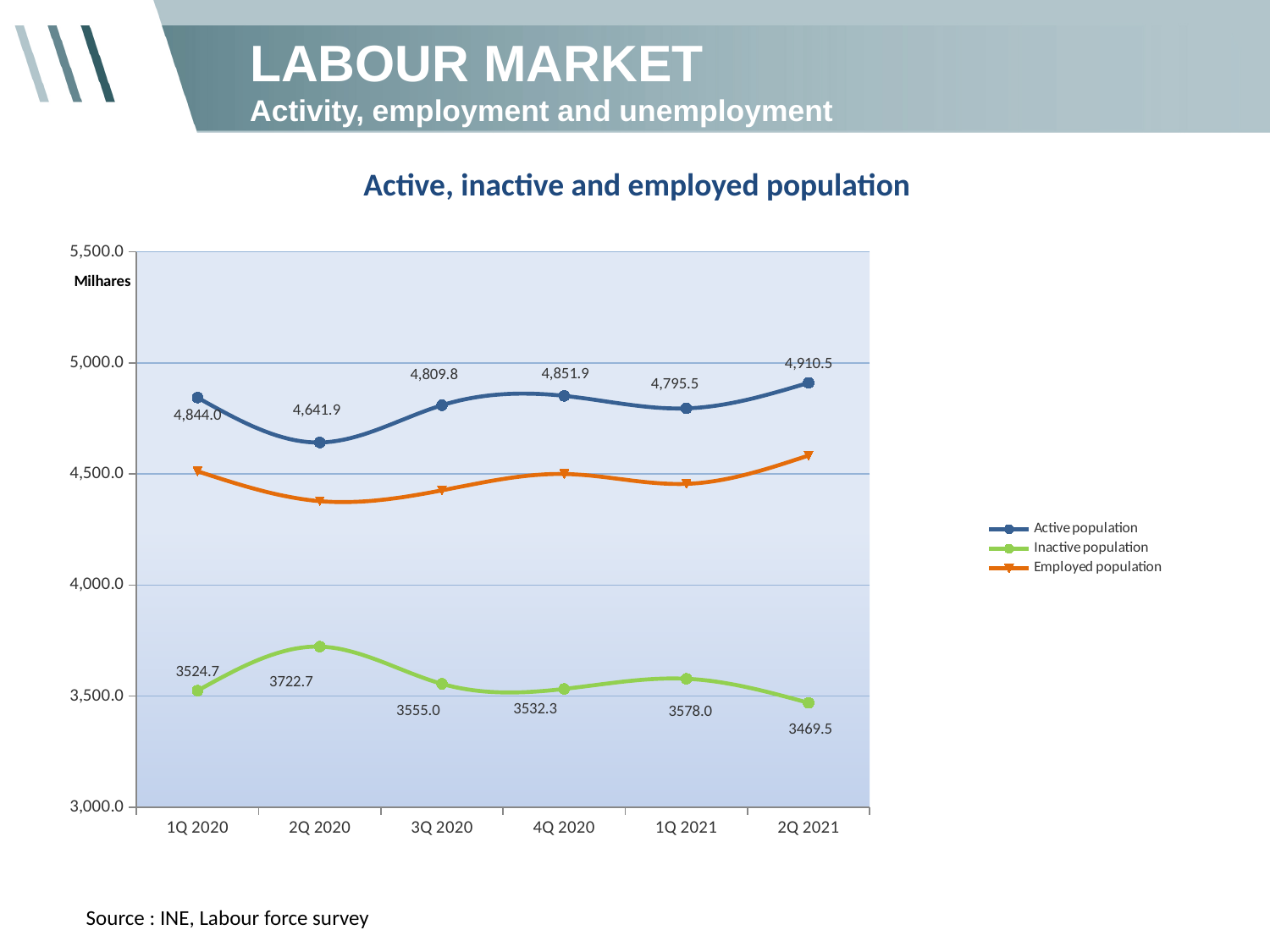
What is the difference between the Active population in 2Q 2021 and in 1Q 2021? 115.0 Is the value for the Employed population in 2Q 2021 greater or less than 4,500.0? greater What is the value of the Inactive population in 2Q 2020? 3722.7 What is the value of the Active population in 2Q 2021? 4,910.5 How many series does the legend list? 3 In which quarter is the Active population lowest? 2Q 2020 In which quarter is the Inactive population lowest? 2Q 2021 How many quarters are shown on the x axis? 6 Is the value for the Employed population in 2Q 2020 greater or less than 4,500.0? less In which quarter is the Inactive population highest? 2Q 2020 What kind of chart is shown on the slide? Line chart Which is larger: the Inactive population in 1Q 2021 or in 4Q 2020? 1Q 2021